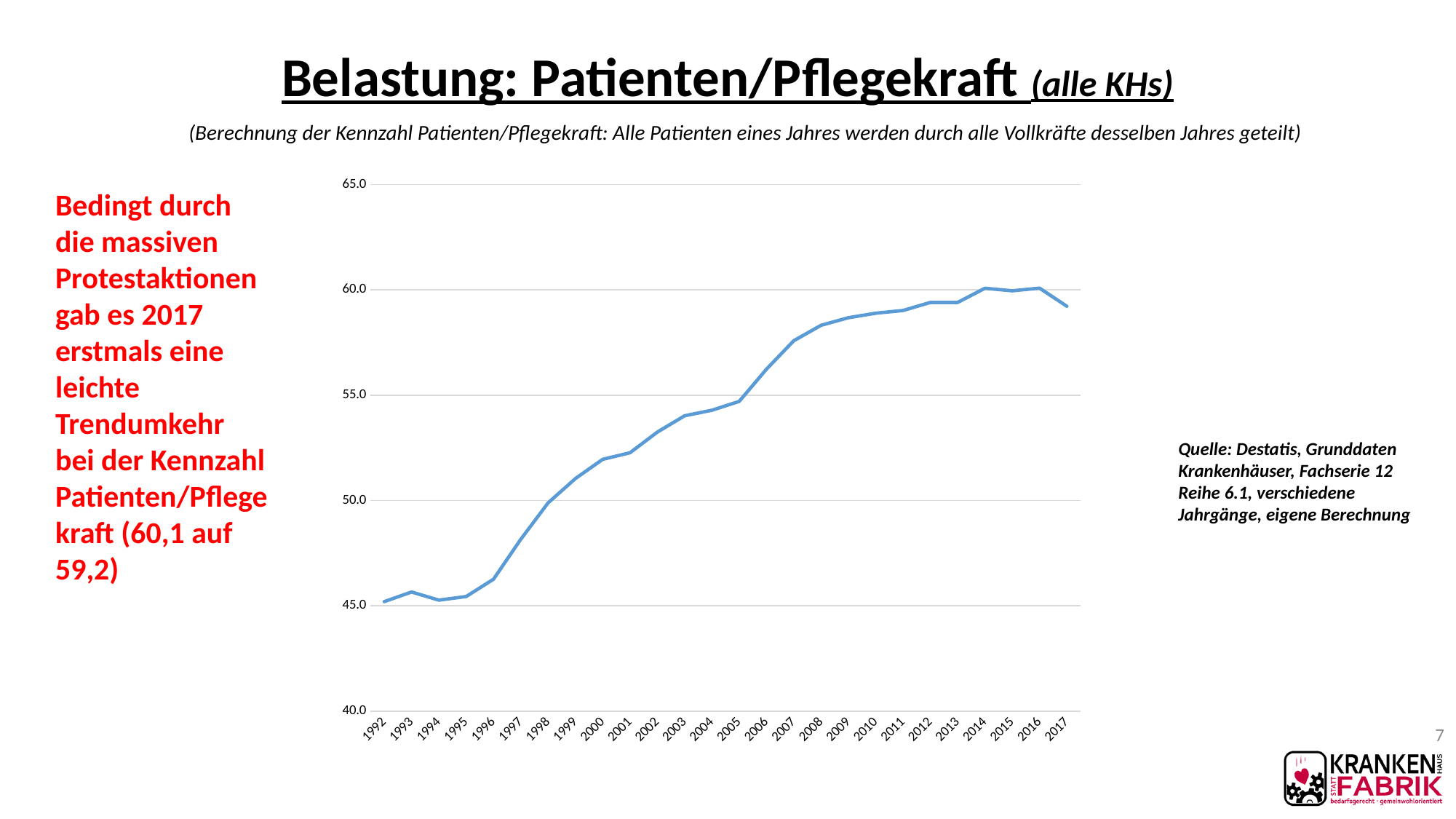
Which year has the larger value, 2003 or 2007? 2007 What kind of chart is shown on the slide? line chart Is the value for 2000 greater or less than 50.0? greater Is the value for 1992 greater or less than 50.0? less Which year has the larger value, 1996 or 2000? 2000 Is the value for 2003 greater or less than 55.0? less Do the values generally rise or fall from 1992 to 2016? rise How many years are plotted along the x axis of the chart? 26 According to the slide text, what is the Patienten/Pflegekraft value for 2017? 59,2 What is the first year shown on the x axis of the chart? 1992